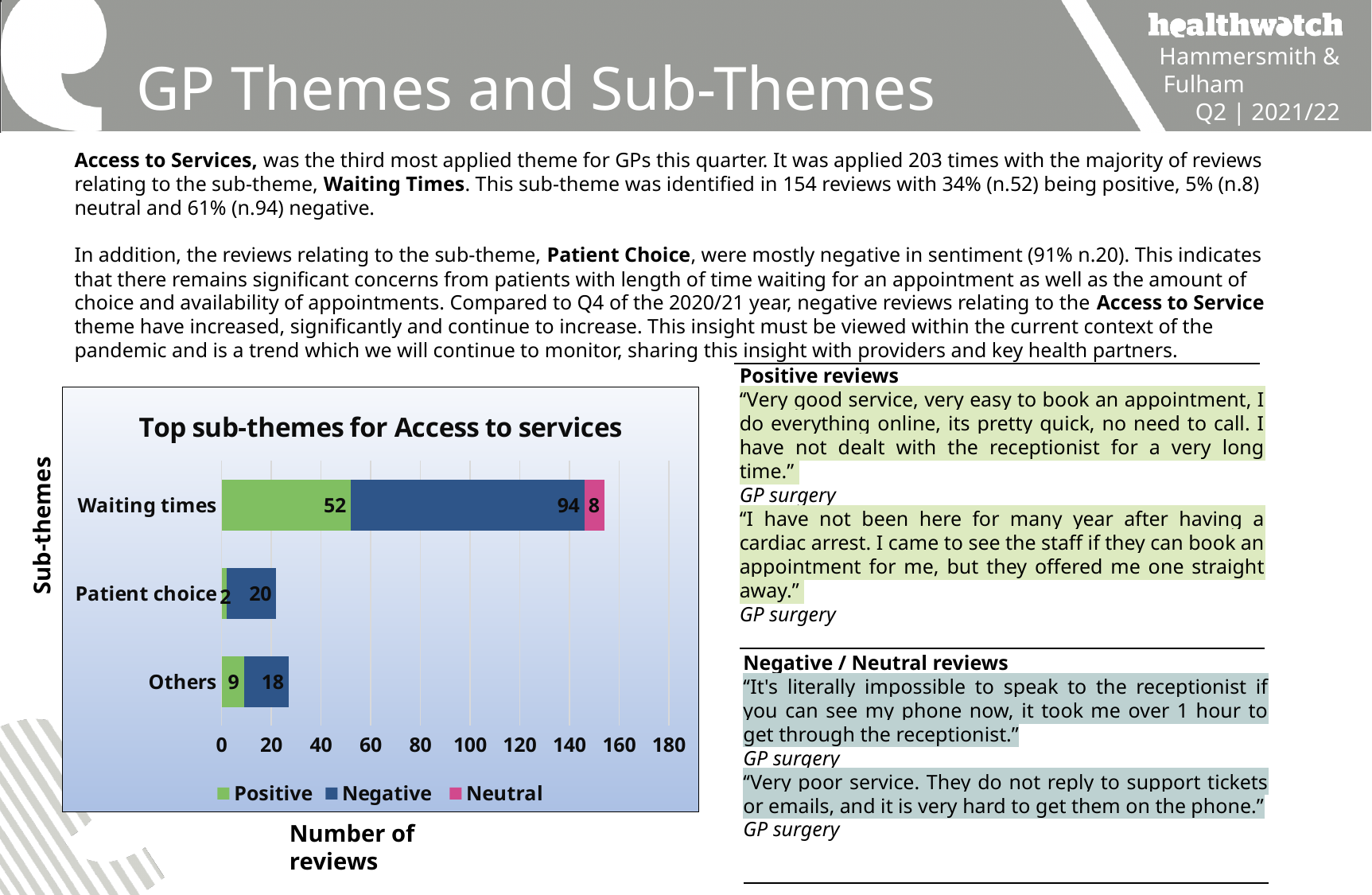
Which sub-theme has the highest number of Negative reviews? Waiting times What is the total number of reviews in the Waiting times bar? 154 What type of chart is shown on the slide? bar chart What is the difference between the Negative and Positive review counts for Waiting times? 42 What is the number of Positive reviews for Waiting times? 52 Which sub-theme has the lowest number of Positive reviews? Patient choice What is the number of Positive reviews for Others? 9 How many series does the legend of the chart list? 3 What is the number of Negative reviews for Waiting times? 94 How many sub-themes are plotted in the chart? 3 What is the number of Negative reviews for Patient choice? 20 What is the number of Neutral reviews for Waiting times? 8